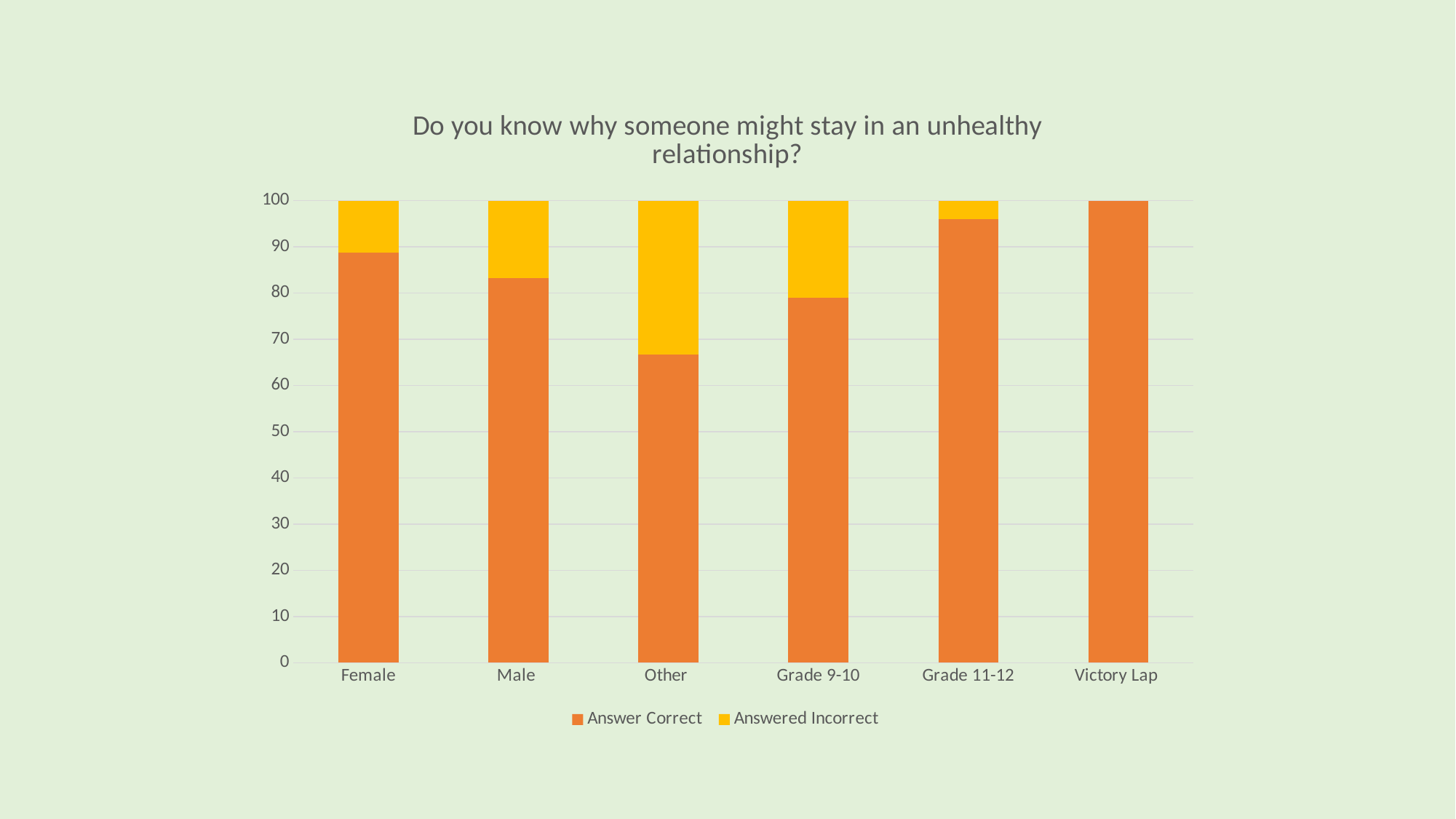
Which category has the largest Answered Incorrect segment? Other What kind of chart is shown on the slide? Stacked bar chart Is the Answer Correct value for Grade 11-12 greater or less than 90? greater What is the total height of the stacked bar for Female? 100 Which has a higher Answer Correct value, Female or Male? Female Is the Answer Correct value for Other greater or less than 80? less Is the Answer Correct value for Female greater or less than 80? greater Which category has the lowest Answer Correct value? Other Which category has the highest Answer Correct value? Victory Lap What is the Answer Correct value for Victory Lap? 100 How many series does the legend list? 2 How many categories are shown along the x axis? 6